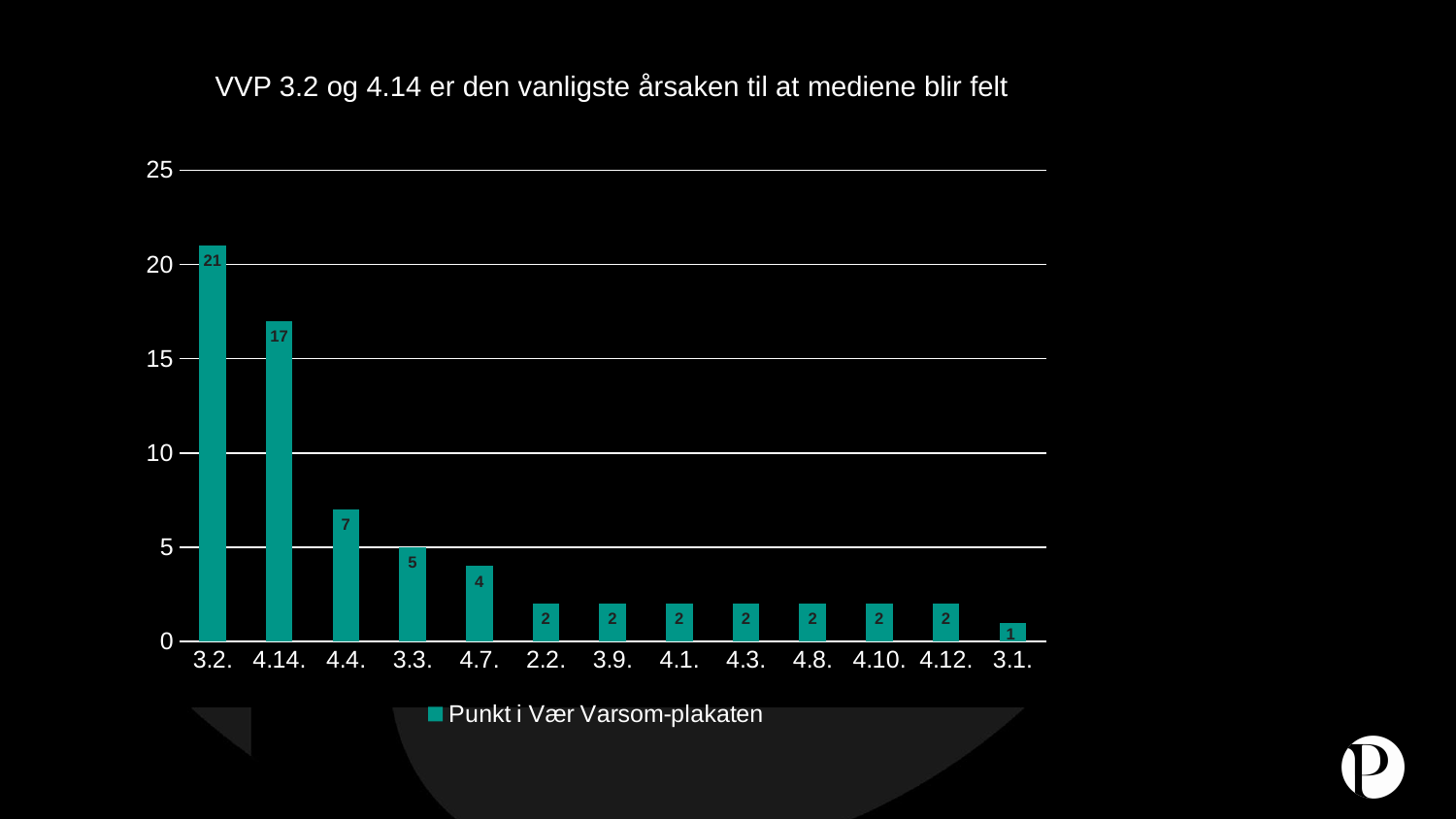
What is the value for category 3.2.? 21 Which category has the highest value? 3.2. What is the value for category 4.4.? 7 Is the value for 4.4. greater or less than 5? greater What is the difference between the values for 3.2. and 4.14.? 4 How many categories are shown on the x axis? 13 Which category has the lowest value? 3.1. What is the value for category 4.14.? 17 Which is larger, the value for 3.3. or the value for 4.7.? 3.3. What kind of chart is shown on the slide? bar chart What is the value for category 4.7.? 4 What is the legend entry for the series? Punkt i Vær Varsom-plakaten